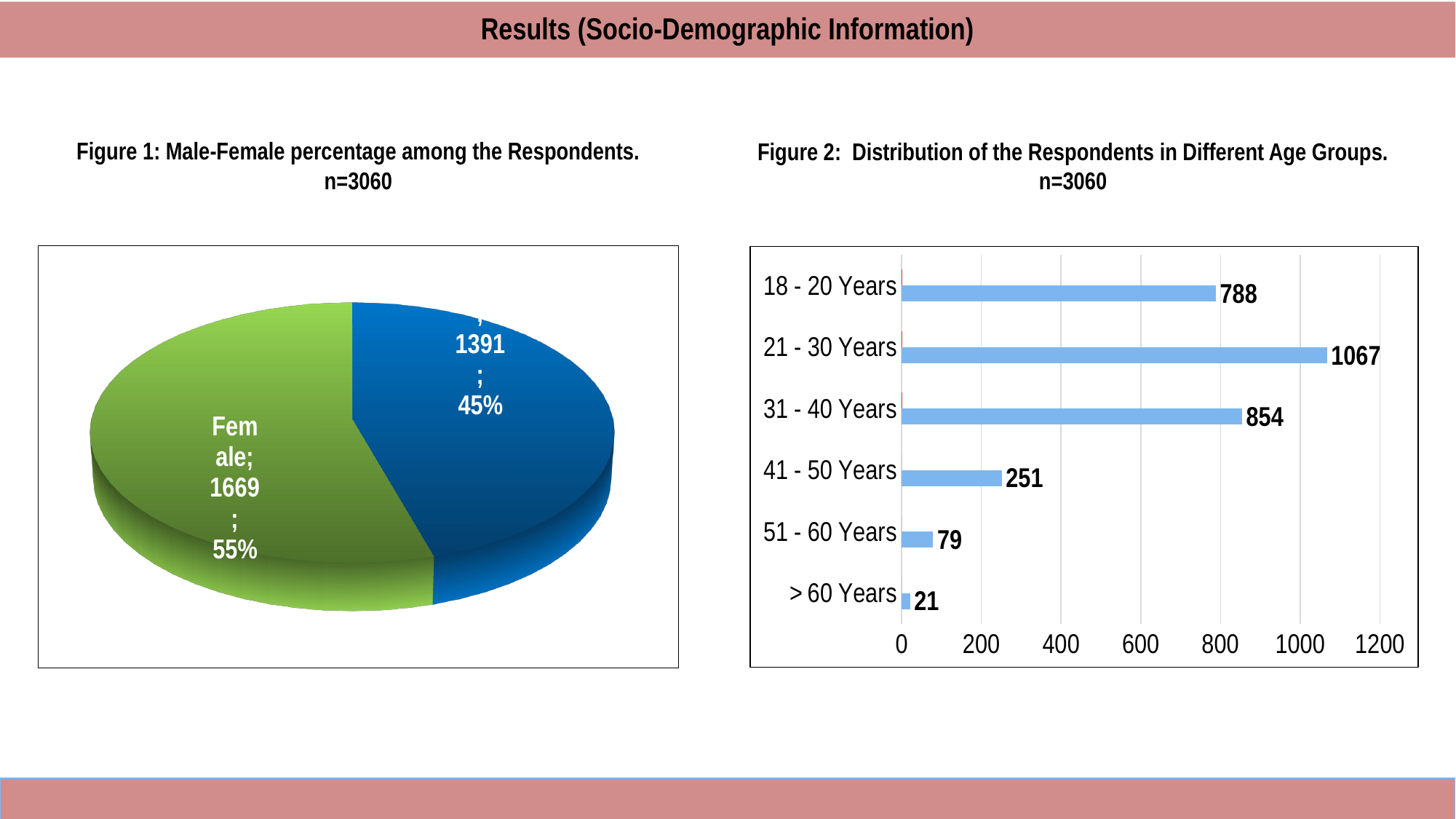
In Figure 2, which is larger, the value for 41 - 50 Years or the value for 51 - 60 Years? 41 - 50 Years What kind of chart is Figure 2? Bar chart How many age groups are shown in Figure 2? 6 In Figure 1, what percentage is shown on the blue slice? 45% In Figure 2, which age group has the lowest value? > 60 Years In Figure 2, what is the value for 51 - 60 Years? 79 In Figure 2, what is the difference between the values for 31 - 40 Years and 18 - 20 Years? 66 In Figure 2, what is the value for 21 - 30 Years? 1067 In Figure 1, what percentage share does the Female slice have? 55% What kind of chart is Figure 1? Pie chart In Figure 2, which age group has the highest value? 21 - 30 Years In Figure 1, what value is shown for Female? 1669